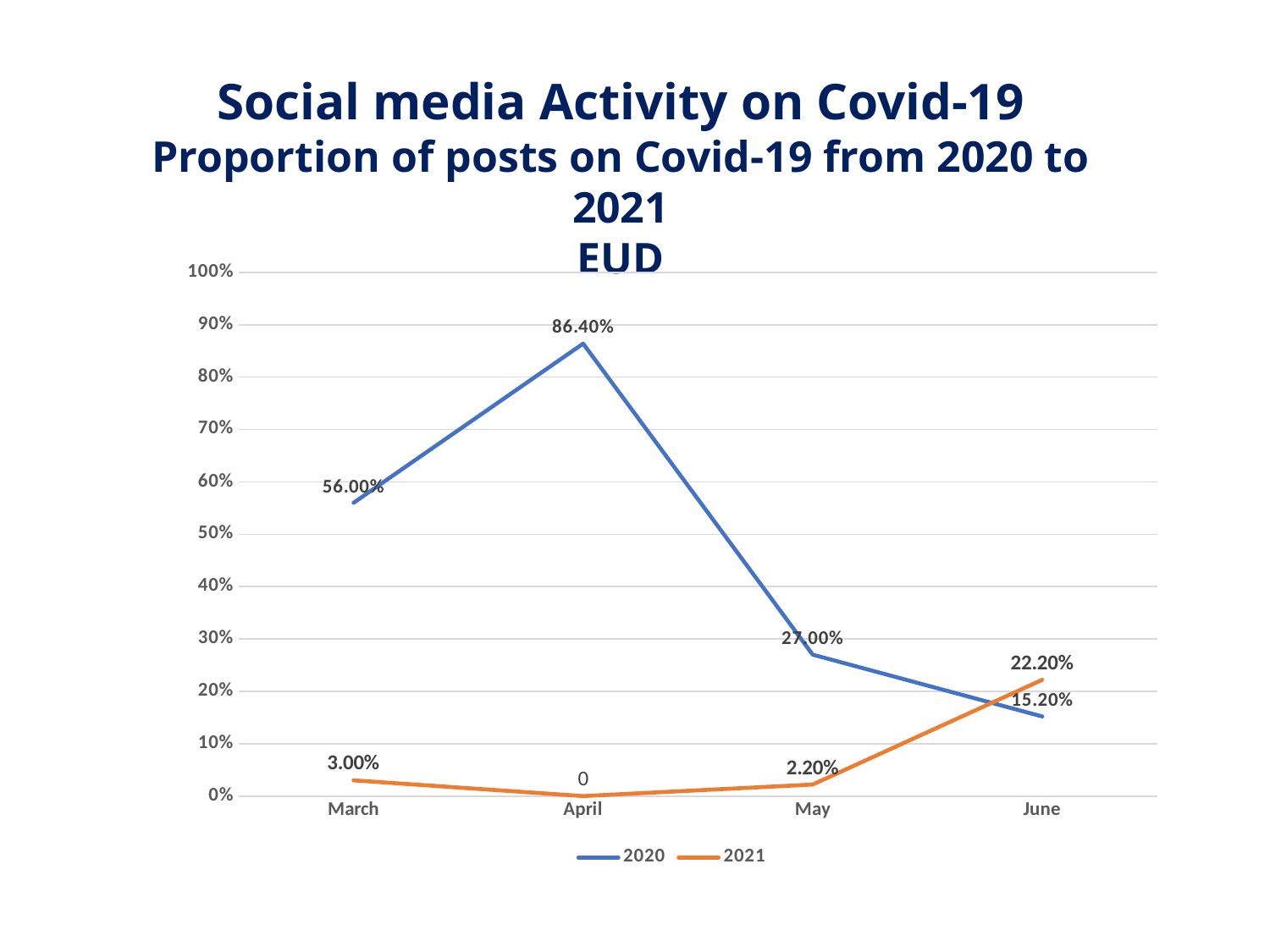
In which month is the 2020 series lowest? June Does the 2021 series rise or fall from May to June? Rise What is the difference between the 2020 values for April and May? 59.40% How many months are shown on the x axis? 4 Which is larger in June, the 2020 value or the 2021 value? 2021 What kind of chart is shown? Line chart What is the value for 2021 in April? 0 What is the value for 2020 in April? 86.40% In which month is the 2020 series highest? April How many series does the legend list? 2 What is the value for 2021 in June? 22.20% What is the value for 2020 in March? 56.00%